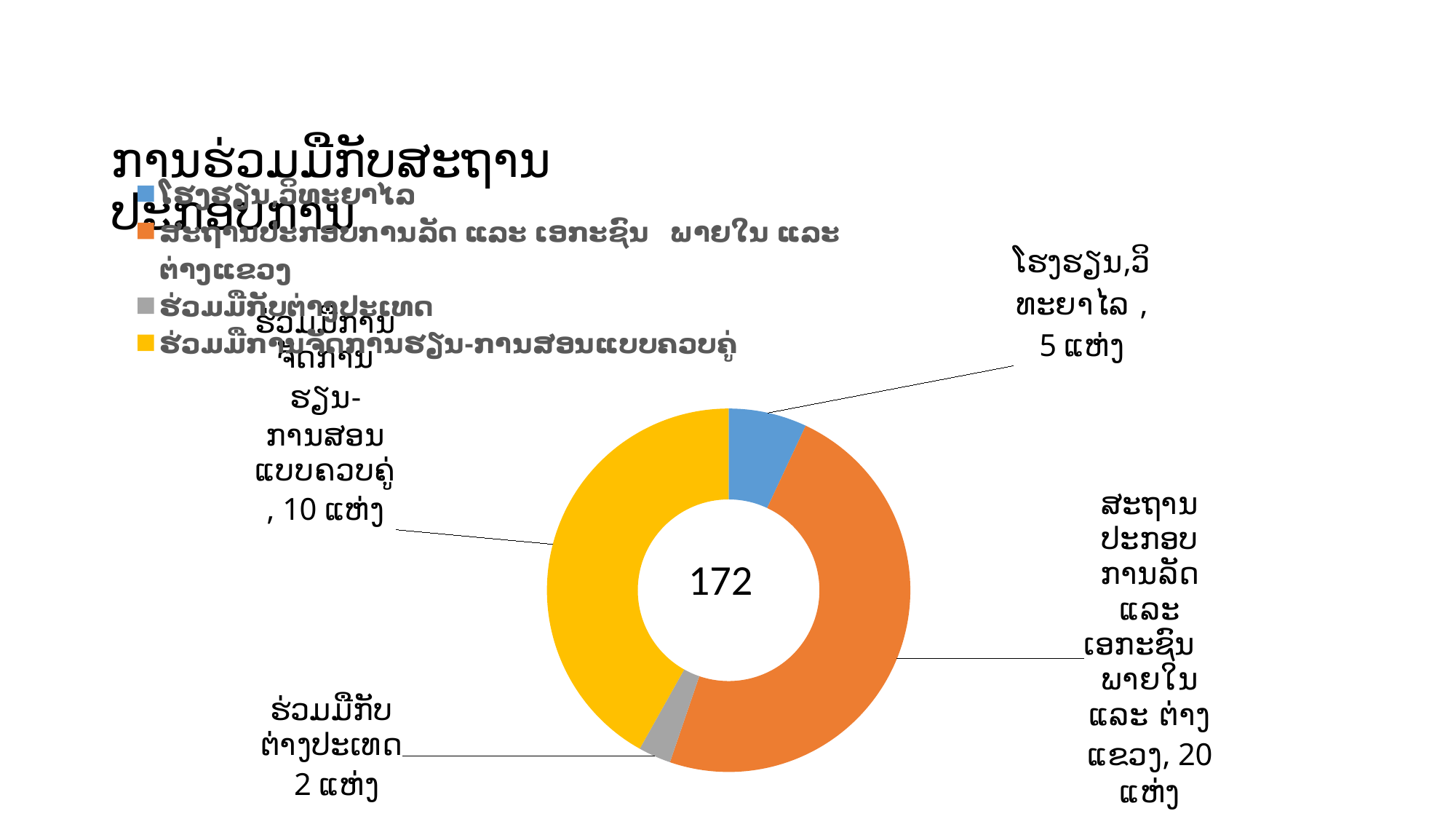
What number is printed in the centre of the doughnut chart? 172 What value is labelled for the ຮ່ວມມືການຈັດການຮຽນ-ການສອນແບບຄວບຄູ່ slice? 10 ແຫ່ງ Which category has the smallest slice in the doughnut chart? ຮ່ວມມືກັບຕ່າງປະເທດ What value is labelled for the ຮ່ວມມືກັບຕ່າງປະເທດ slice? 2 ແຫ່ງ What value is labelled for the ສະຖານປະກອບການລັດ ແລະ ເອກະຊົນ ພາຍໃນ ແລະ ຕ່າງແຂວງ slice? 20 ແຫ່ງ What value is labelled for the ໂຮງຮຽນ,ວິທະຍາໄລ slice? 5 ແຫ່ງ How many categories (slices) does the doughnut chart have? 4 What is the difference between the labelled value for ສະຖານປະກອບການລັດ ແລະ ເອກະຊົນ ພາຍໃນ ແລະ ຕ່າງແຂວງ and the labelled value for ໂຮງຮຽນ,ວິທະຍາໄລ? 15 ແຫ່ງ What colour represents ໂຮງຮຽນ,ວິທະຍາໄລ in the chart? Blue What type of chart is shown on the slide? Doughnut chart How many entries does the legend list? 4 Which is larger: the value for ໂຮງຮຽນ,ວິທະຍາໄລ or the value for ຮ່ວມມືກັບຕ່າງປະເທດ? ໂຮງຮຽນ,ວິທະຍາໄລ